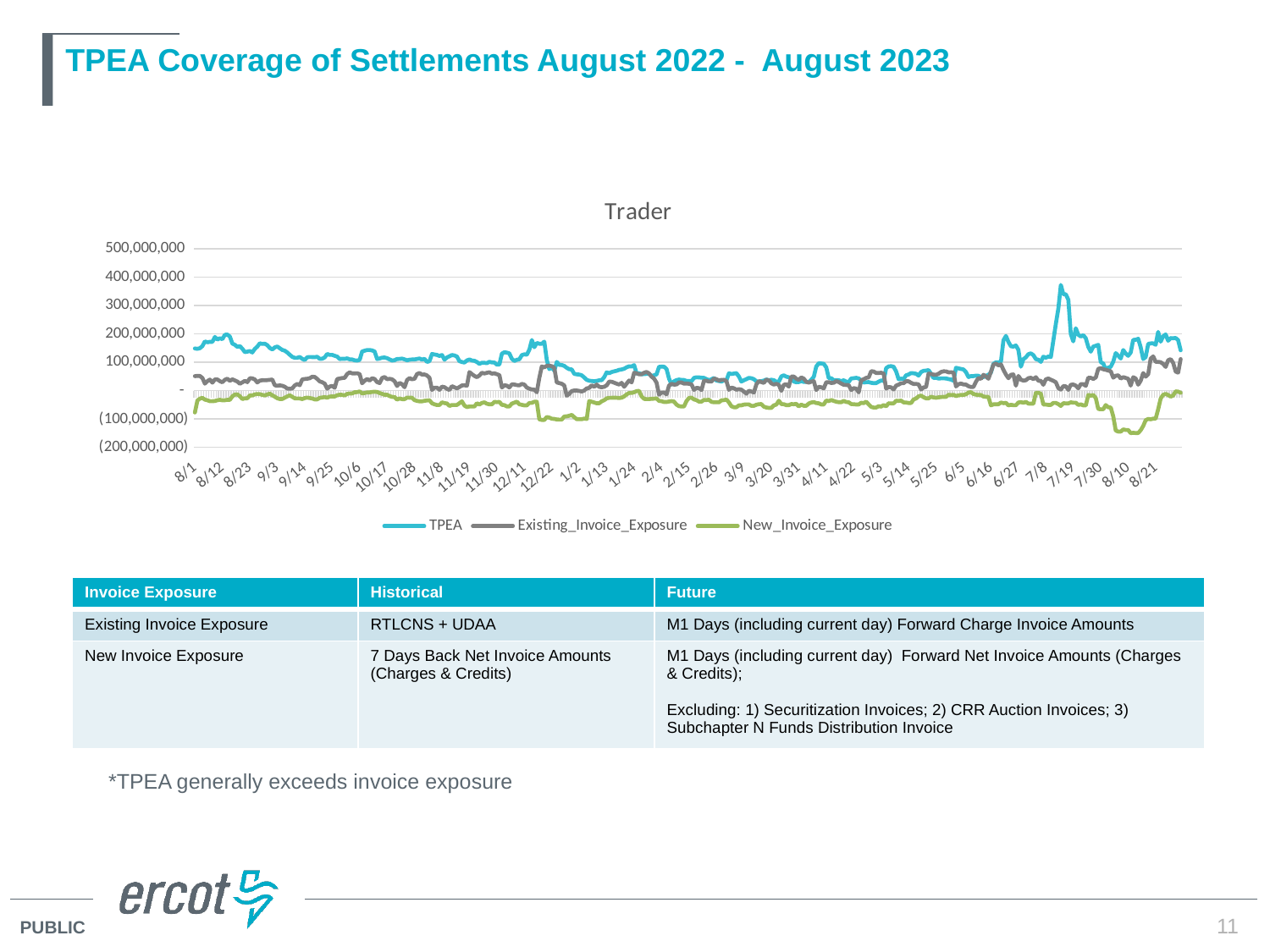
What kind of chart is shown on the slide? line chart Is the value of Existing_Invoice_Exposure at 8/1 greater or less than 100,000,000? less Is the value of New_Invoice_Exposure around 8/10 greater or less than (100,000,000)? less Which series is drawn in green? New_Invoice_Exposure Is the value of TPEA at 8/1 greater or less than 100,000,000? greater Around 7/19, which is larger: TPEA or New_Invoice_Exposure? TPEA Which series reaches the highest value on the chart? TPEA Which series reaches the lowest value on the chart? New_Invoice_Exposure What is the title of the chart? Trader Between 8/12 and 1/2, does the TPEA line generally rise or fall? fall How many series does the chart legend list? 3